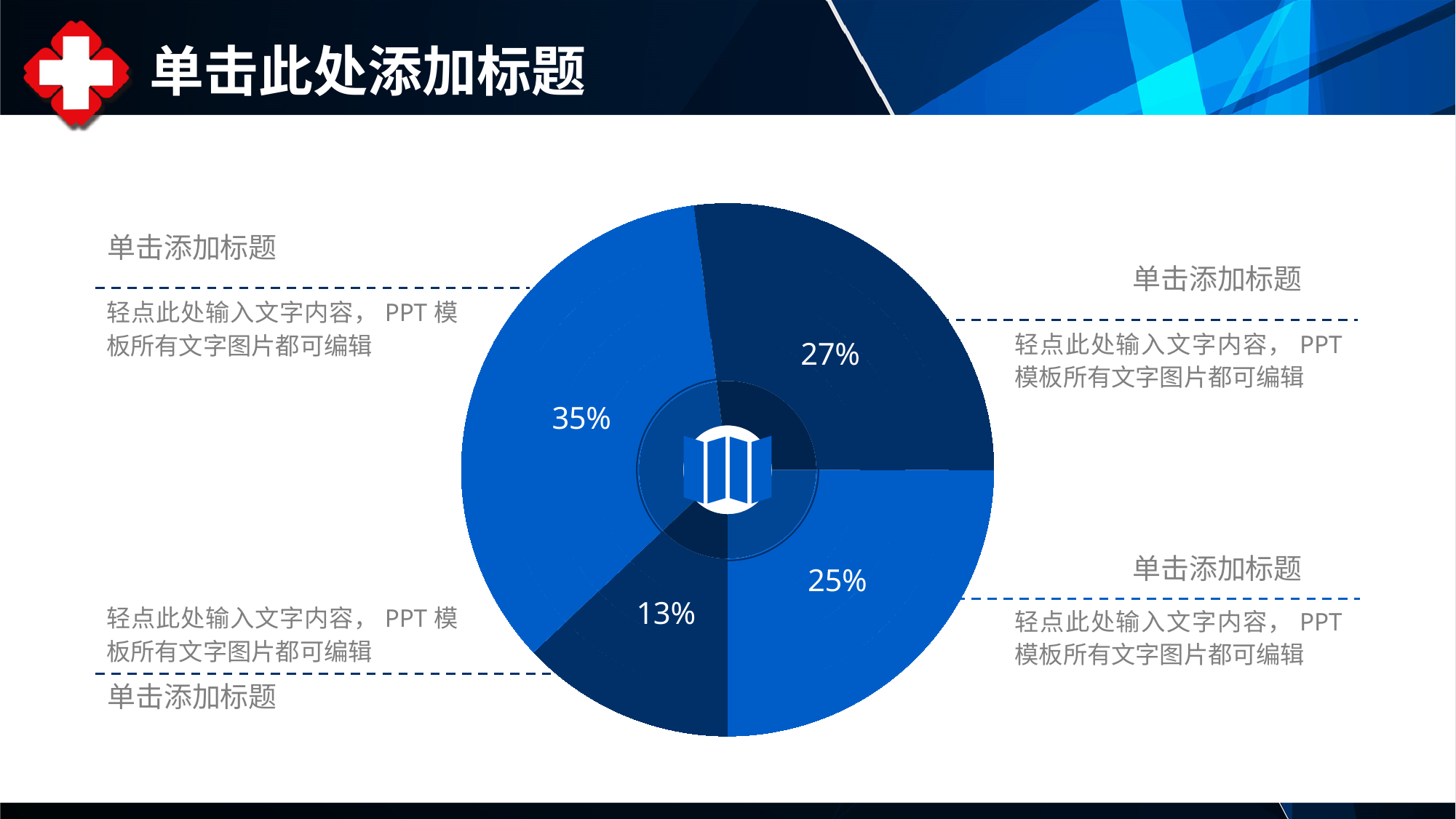
What is the smallest percentage shown on the pie chart? 13% What is the title shown in the slide header? 单击此处添加标题 What percentage is labelled on the upper-right slice of the pie chart? 27% Which is larger, the upper-right slice or the lower-right slice of the pie chart? the upper-right slice (27%) What is the difference between the largest slice (35%) and the smallest slice (13%)? 22% What is the largest percentage shown on the pie chart? 35% What do the four percentages on the pie chart add up to? 100% How many slices does the pie chart have? 4 What percentage is labelled on the large slice on the left side of the pie chart? 35% What percentage is labelled on the small slice at the bottom of the pie chart? 13% What percentage is labelled on the lower-right slice of the pie chart? 25% What kind of chart is shown on the slide? pie chart